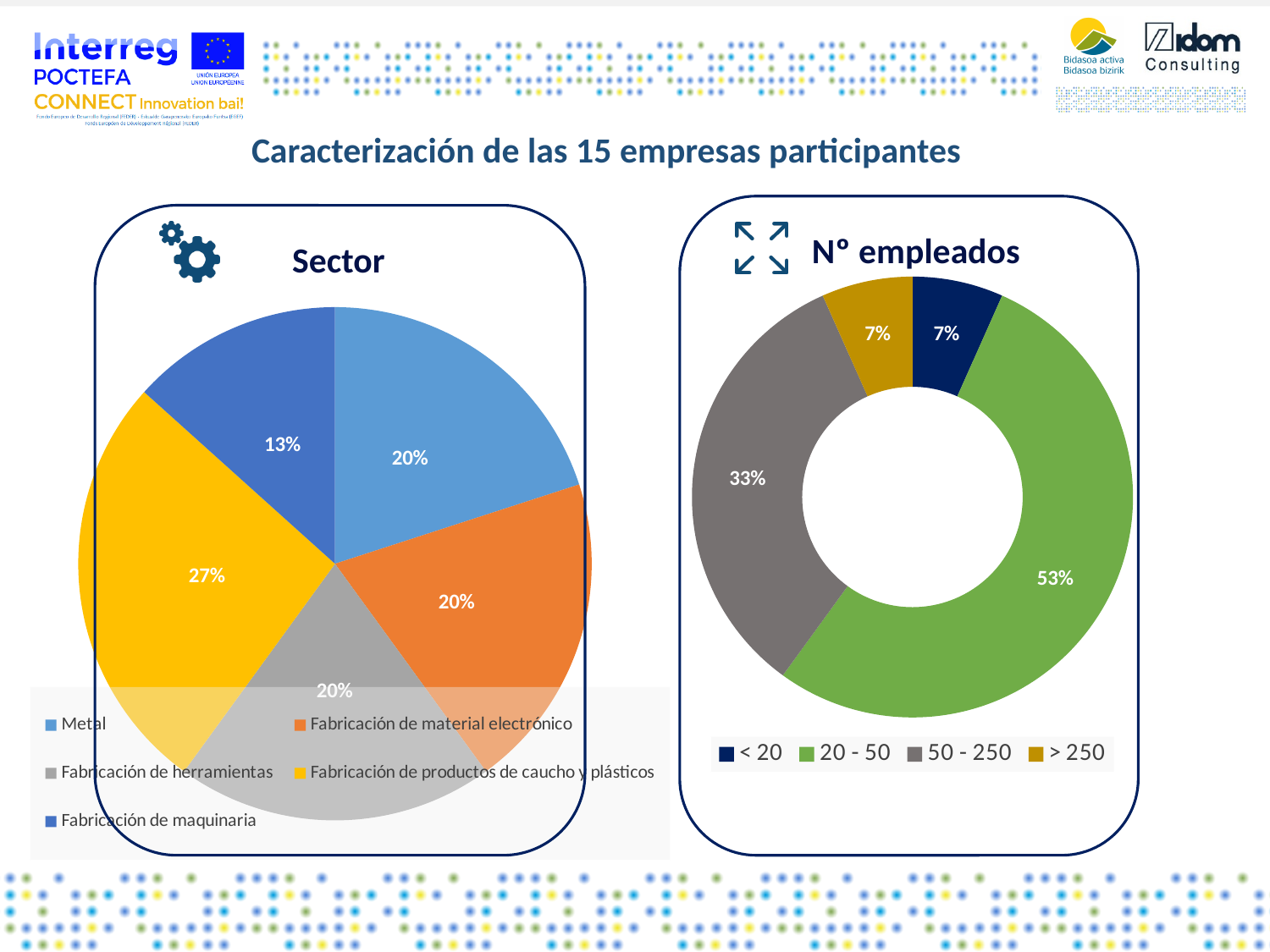
What kind of chart is the 'Sector' chart? Pie chart In the 'Sector' chart, what share is shown for Fabricación de maquinaria? 13% In the 'Nº empleados' chart, which is larger: the share for 50 - 250 or the share for > 250? 50 - 250 In the 'Sector' chart, which sector has the smallest share? Fabricación de maquinaria In the 'Sector' chart, what share is shown for Fabricación de productos de caucho y plásticos? 27% In the 'Sector' chart, which sector has the largest share? Fabricación de productos de caucho y plásticos In the 'Nº empleados' chart, what share is shown for the 20 - 50 category? 53% How many sectors are shown in the 'Sector' chart? 5 How many categories does the legend of the 'Nº empleados' chart list? 4 In the 'Sector' chart, what is the difference between the shares of Fabricación de productos de caucho y plásticos and Fabricación de maquinaria? 14% In the 'Nº empleados' chart, what share is shown for the 50 - 250 category? 33% In the 'Nº empleados' chart, which category has the largest share? 20 - 50